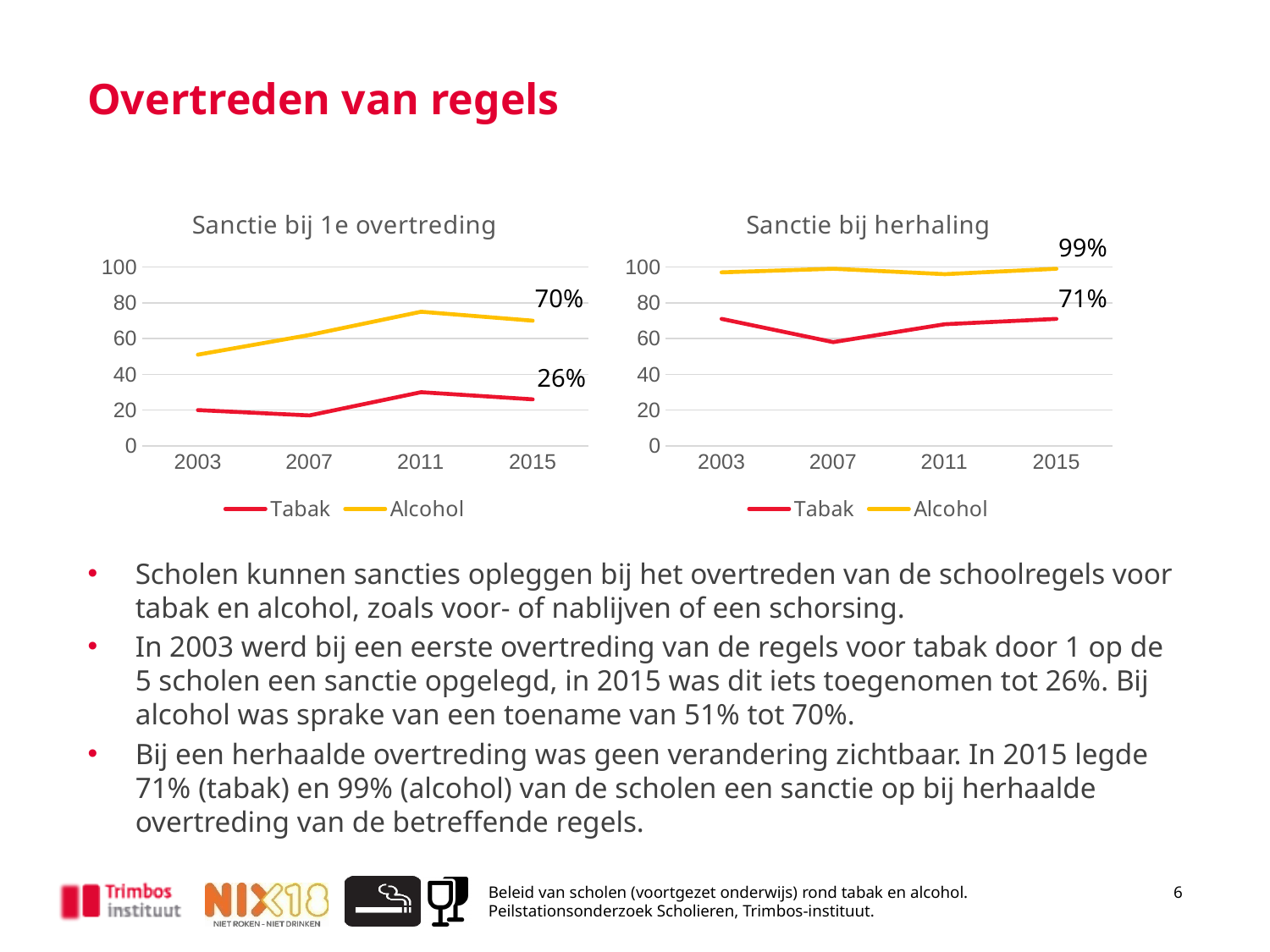
In the 'Sanctie bij 1e overtreding' chart, what is the value for Tabak in 2015? 26% How many series does the legend of the 'Sanctie bij herhaling' chart list? 2 In the 'Sanctie bij herhaling' chart, what is the value for Alcohol in 2015? 99% In the 'Sanctie bij herhaling' chart, what is the value for Tabak in 2015? 71% In the 'Sanctie bij 1e overtreding' chart, is the value for Alcohol in 2003 greater or less than 60? less In the 'Sanctie bij 1e overtreding' chart, what is the difference between the Alcohol and Tabak values in 2015? 44 percentage points What kind of chart is the 'Sanctie bij 1e overtreding' chart? Line chart How many years are plotted on the x axis of the 'Sanctie bij 1e overtreding' chart? 4 In the 'Sanctie bij 1e overtreding' chart, what is the value for Alcohol in 2015? 70% In the 'Sanctie bij herhaling' chart, is the value for Alcohol in 2003 greater or less than 80? greater In the 'Sanctie bij herhaling' chart, what is the difference between the Alcohol and Tabak values in 2015? 28 percentage points In the 'Sanctie bij herhaling' chart, which series has the higher value in 2015, Tabak or Alcohol? Alcohol